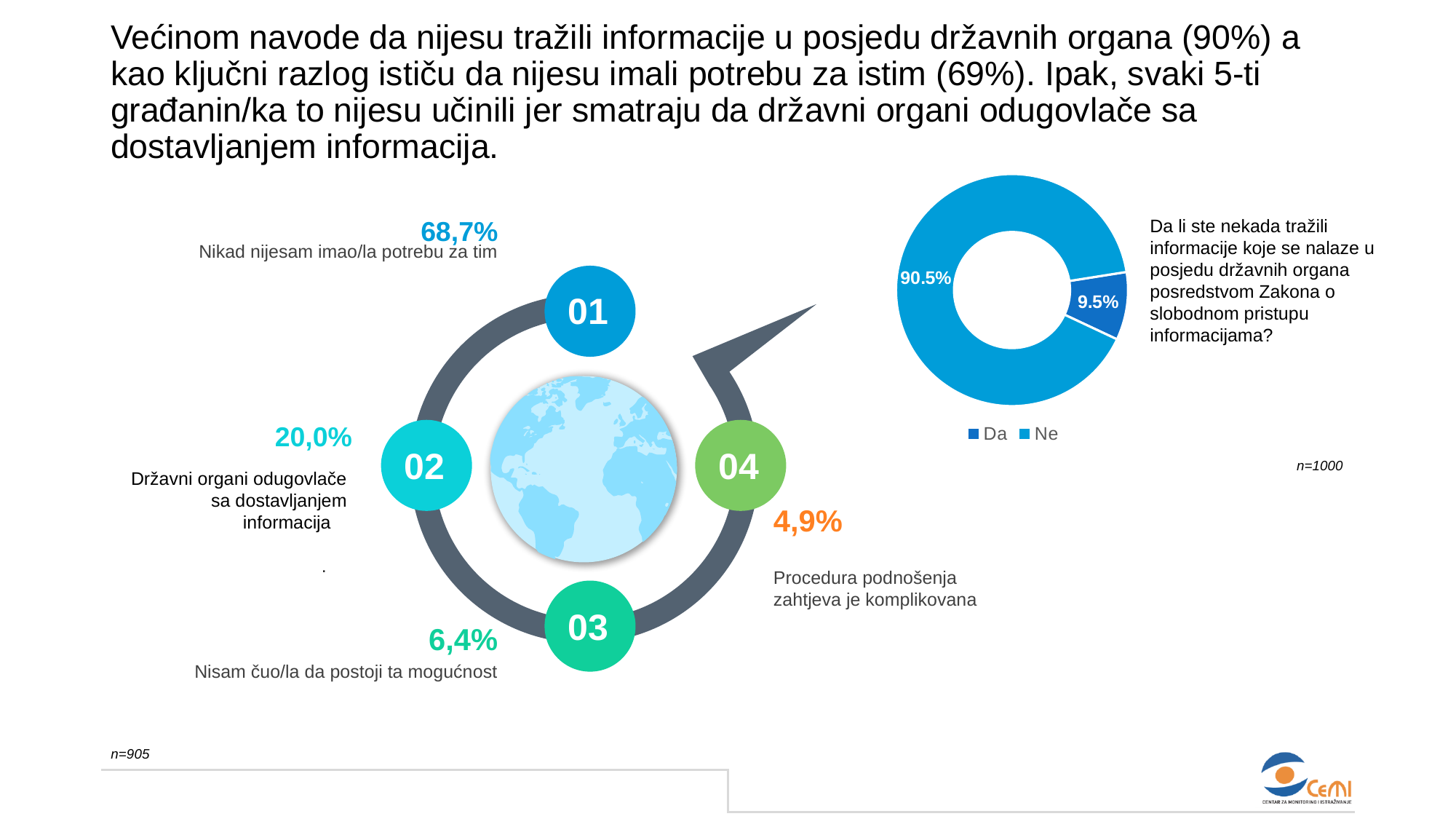
In the circular infographic on the left, how many reasons are shown? 4 What kind of chart is shown on the right side of the slide? Donut (pie) chart In the donut chart on the right, what is the difference in percentage points between the "Ne" and "Da" shares? 81 percentage points In the donut chart on the right, what share of respondents answered "Ne"? 90.5% In the donut chart on the right, what share of respondents answered "Da"? 9.5% In the circular infographic on the left, what is the difference in percentage points between "Nisam čuo/la da postoji ta mogućnost" and "Procedura podnošenja zahtjeva je komplikovana"? 1,5 percentage points In the circular infographic on the left, what percentage is shown for "Državni organi odugovlače sa dostavljanjem informacija"? 20,0% How many entries does the legend of the donut chart on the right list? 2 In the circular infographic on the left, what percentage is shown for "Nikad nijesam imao/la potrebu za tim"? 68,7% In the circular infographic on the left, which reason has the lowest percentage? Procedura podnošenja zahtjeva je komplikovana What sample size (n) is shown next to the donut chart on the right? n=1000 In the donut chart on the right, which answer has the larger share, "Da" or "Ne"? Ne